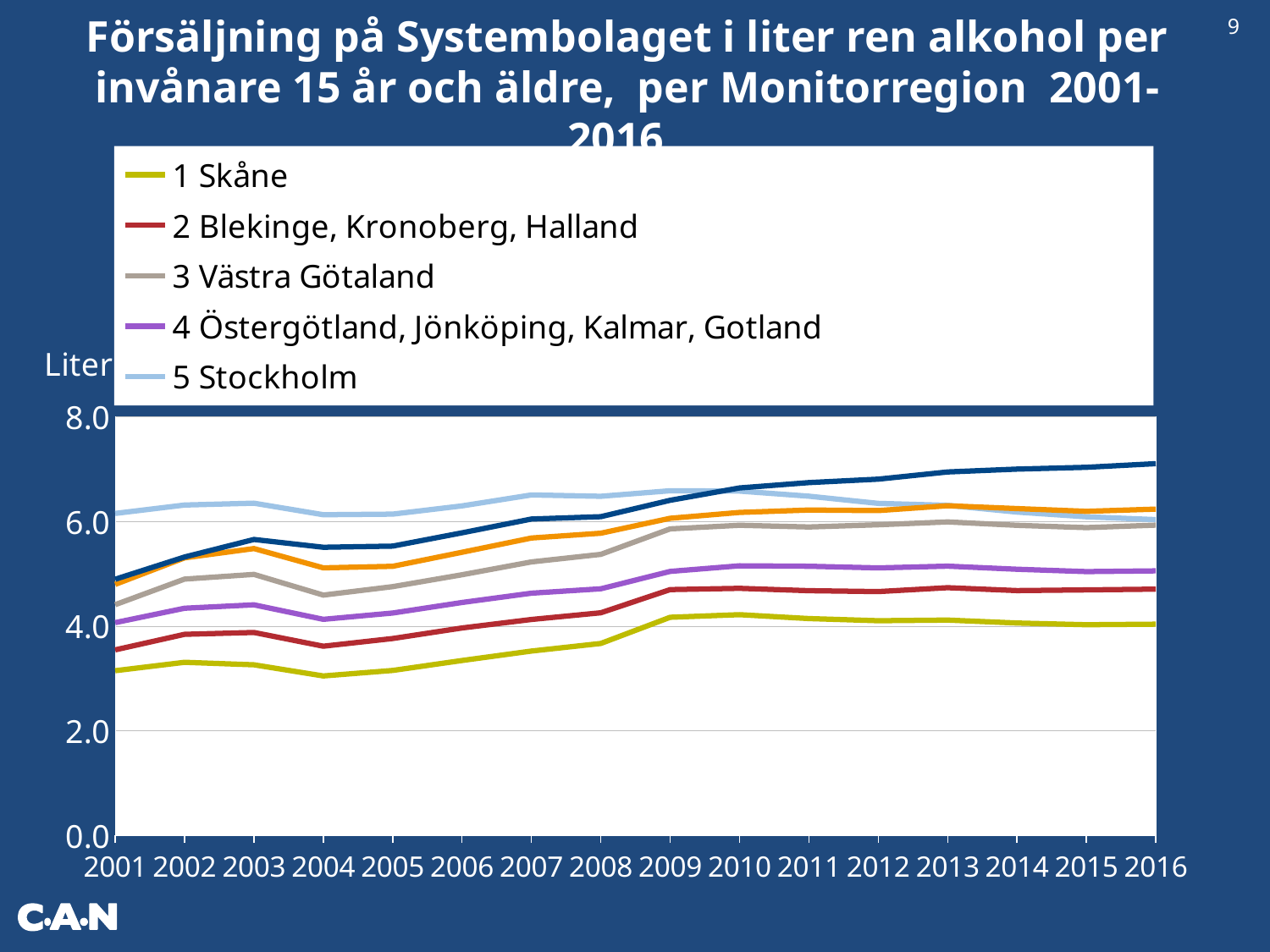
Is the value for 3 Västra Götaland in 2004 greater or less than 6.0? less Which of the series listed in the legend has the lowest value in 2016? 1 Skåne Is the value for 4 Östergötland, Jönköping, Kalmar, Gotland in 2016 greater or less than 4.0? greater Is the value for 2 Blekinge, Kronoberg, Halland in 2004 greater or less than 4.0? less Does the value for 1 Skåne rise or fall from 2001 to 2016? rise What is the label on the y axis of the chart? Liter How many years are shown along the x axis of the chart? 16 How many series does the legend list? 5 What kind of chart is shown on the slide? line chart Which is larger in 2016, the value for 5 Stockholm or the value for 1 Skåne? 5 Stockholm